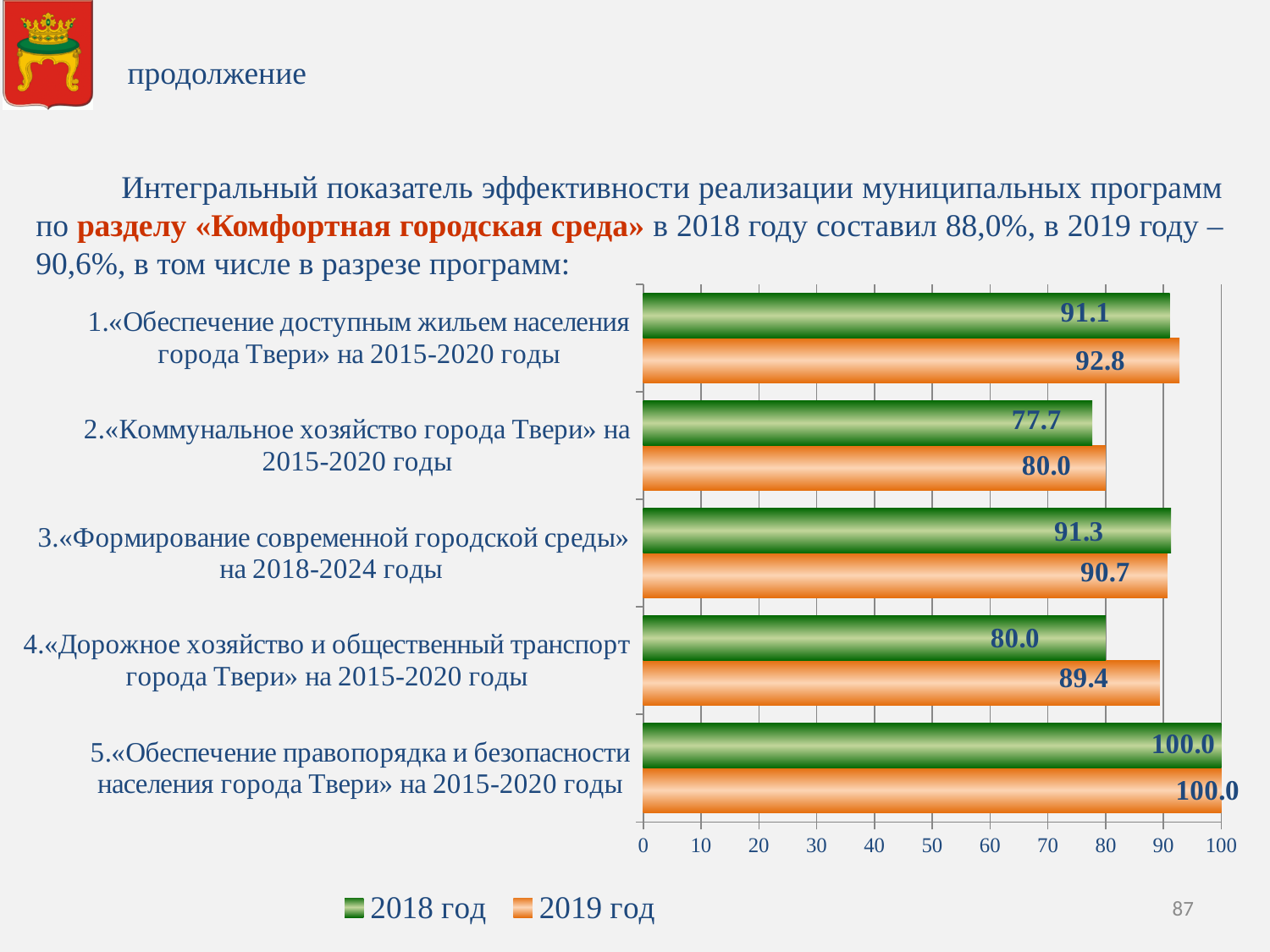
For «Формирование современной городской среды» на 2018-2024 годы, which year has the larger value, 2018 год or 2019 год? 2018 год How many series does the legend list? 2 Which colour represents 2019 год in the chart? orange Which program has the highest 2019 год value? 5.«Обеспечение правопорядка и безопасности населения города Твери» на 2015-2020 годы How many programs (categories) are shown in the chart? 5 What is the 2019 год value for «Дорожное хозяйство и общественный транспорт города Твери» на 2015-2020 годы? 89.4 What type of chart is shown on the slide? bar chart What is the 2018 год value for «Коммунальное хозяйство города Твери» на 2015-2020 годы? 77.7 Which program has the lowest 2018 год value? 2.«Коммунальное хозяйство города Твери» на 2015-2020 годы What is the 2019 год value for «Обеспечение доступным жильем населения города Твери» на 2015-2020 годы? 92.8 Is the 2018 год value for «Коммунальное хозяйство города Твери» на 2015-2020 годы greater or less than 80? less What is the difference between the 2019 год and 2018 год values for «Дорожное хозяйство и общественный транспорт города Твери» на 2015-2020 годы? 9.4